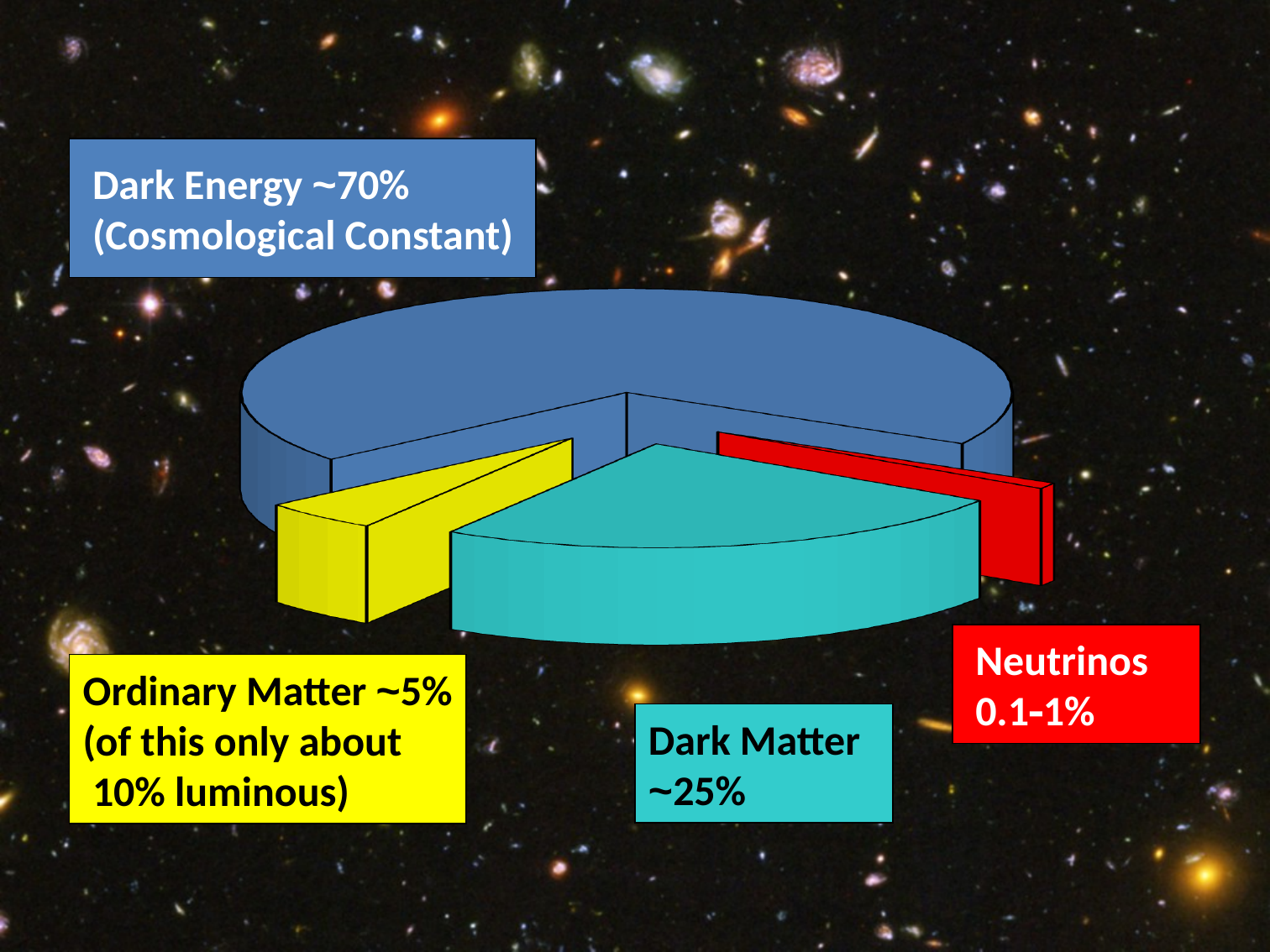
What kind of chart is shown on the slide? pie chart Which is larger, the Dark Matter slice or the Ordinary Matter slice? Dark Matter What percentage label is shown for Ordinary Matter? ~5% Which component has the largest slice of the pie chart? Dark Energy What colour is the Dark Matter slice of the pie chart? cyan What percentage label is shown for Dark Matter? ~25% What percentage range is shown for Neutrinos? 0.1-1% Which is larger, the Ordinary Matter slice or the Neutrinos slice? Ordinary Matter What percentage label is shown for Dark Energy? ~70% Which component has the smallest slice of the pie chart? Neutrinos How many slices does the pie chart have? 4 What is written in parentheses under the Dark Energy label? Cosmological Constant